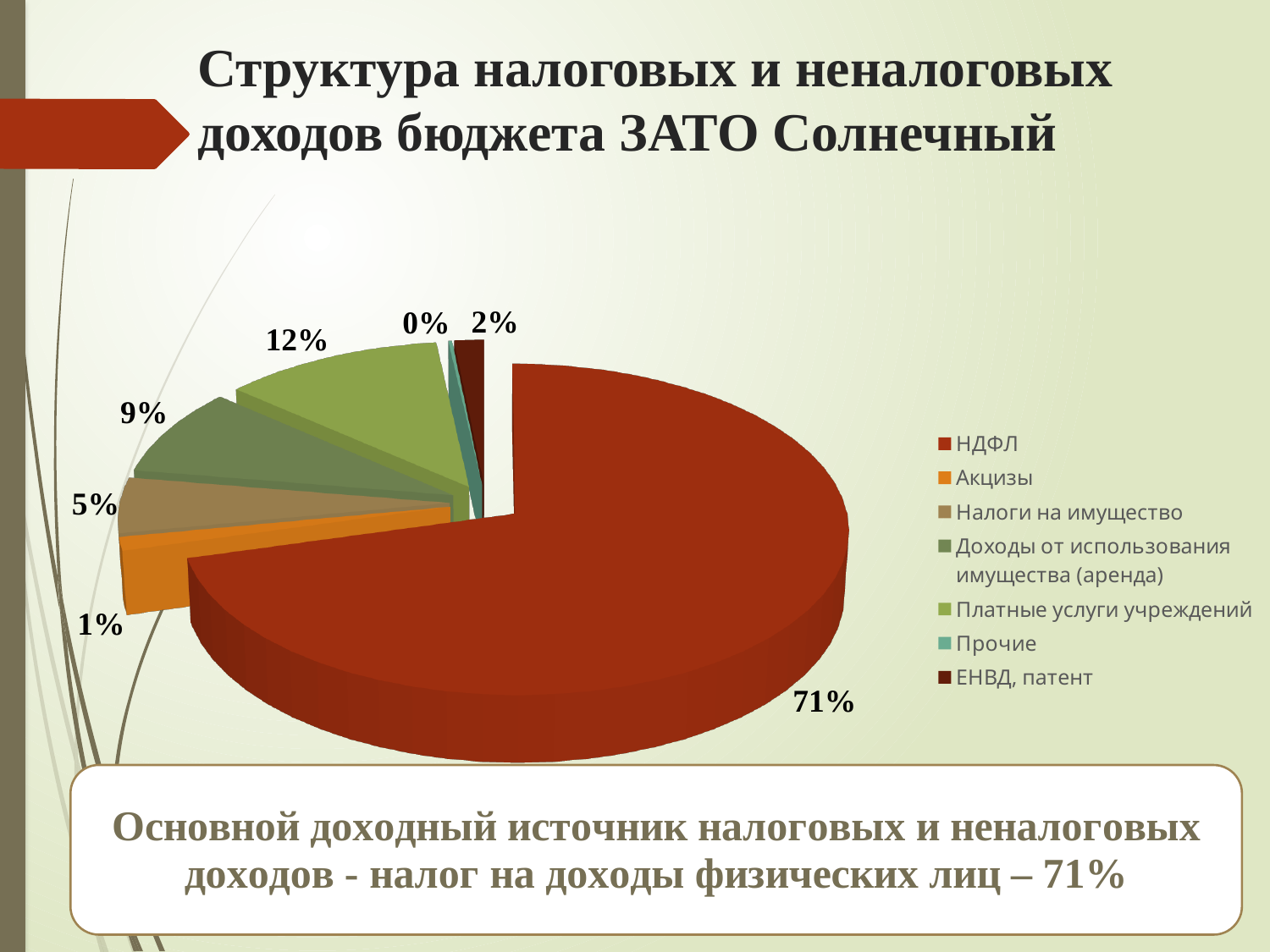
What is the difference between the shares of НДФЛ and Платные услуги учреждений? 59% What kind of chart is shown on the slide? pie chart What is the value shown for Налоги на имущество? 5% What is the value shown for Прочие? 0% Which is larger, the share of Платные услуги учреждений or the share of Доходы от использования имущества (аренда)? Платные услуги учреждений What is the value shown for ЕНВД, патент? 2% What is the value shown for Доходы от использования имущества (аренда)? 9% What share of the pie does НДФЛ account for? 71% Which category has the smallest share of the pie? Прочие How many categories does the legend list? 7 Which category has the largest share of the pie? НДФЛ What is the value shown for Платные услуги учреждений? 12%